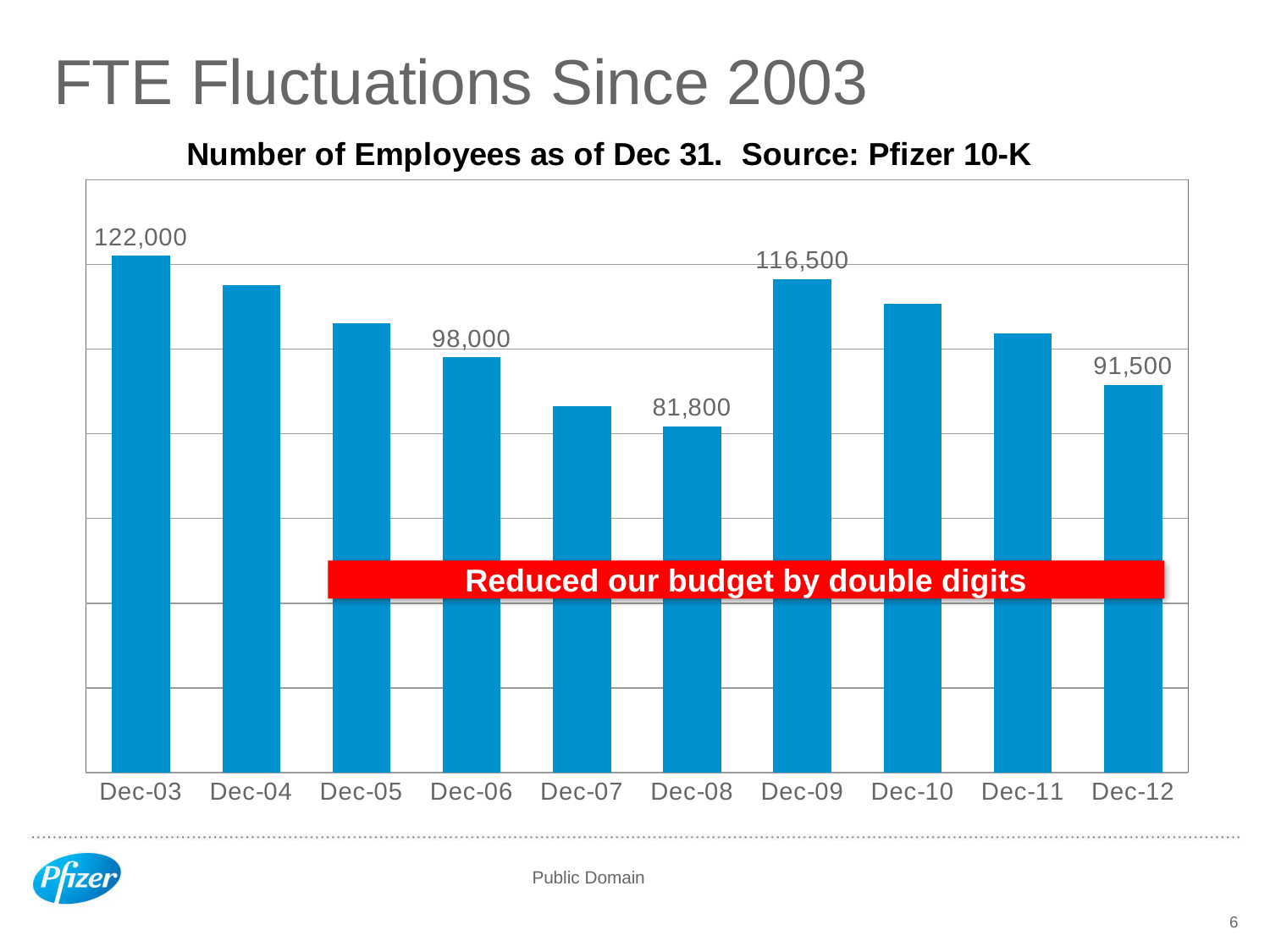
What is the difference in employees between Dec-09 and Dec-12? 25,000 What is the number of employees as of Dec-06? 98,000 Which has more employees, Dec-06 or Dec-12? Dec-06 Which date has the highest number of employees? Dec-03 Do the values rise or fall from Dec-03 to Dec-08? fall What is the difference in employees between Dec-03 and Dec-08? 40,200 What is the number of employees as of Dec-09? 116,500 How many dates are shown on the x axis? 10 Which date has the lowest number of employees? Dec-08 What is the number of employees as of Dec-03? 122,000 What is the number of employees as of Dec-12? 91,500 What is the number of employees as of Dec-08? 81,800